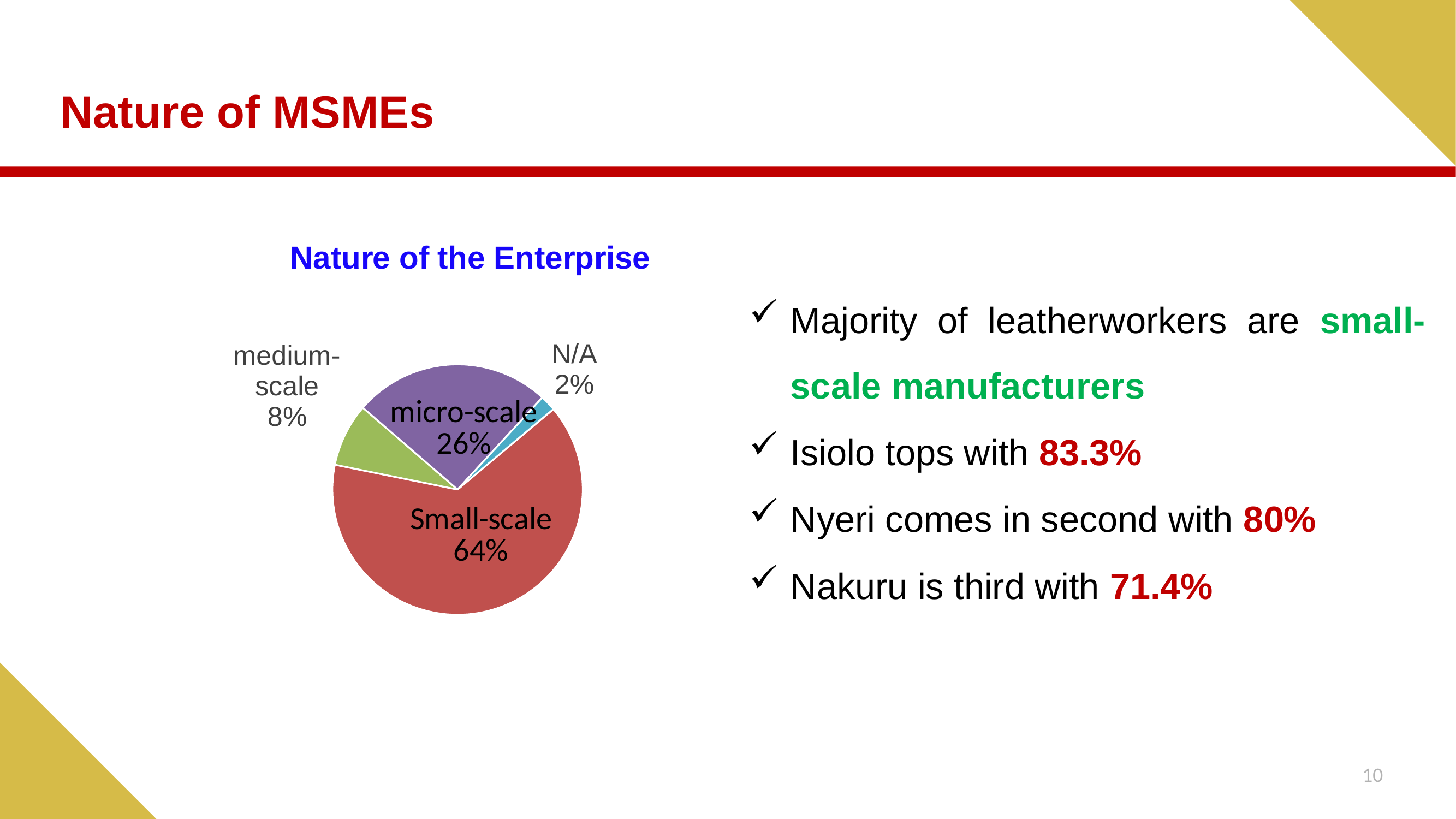
What share of the pie is micro-scale? 26% Which is larger, the medium-scale share or the micro-scale share? micro-scale Which category has the smallest slice of the pie? N/A What share of the pie is N/A? 2% What share of the pie is Small-scale? 64% How many slices does the pie chart have? 4 What is the title of the chart? Nature of the Enterprise What type of chart is shown on the slide? pie chart Which category has the largest slice of the pie? Small-scale What share of the pie is medium-scale? 8% What is the difference between the Small-scale and micro-scale shares? 38% What colour is the Small-scale slice? red